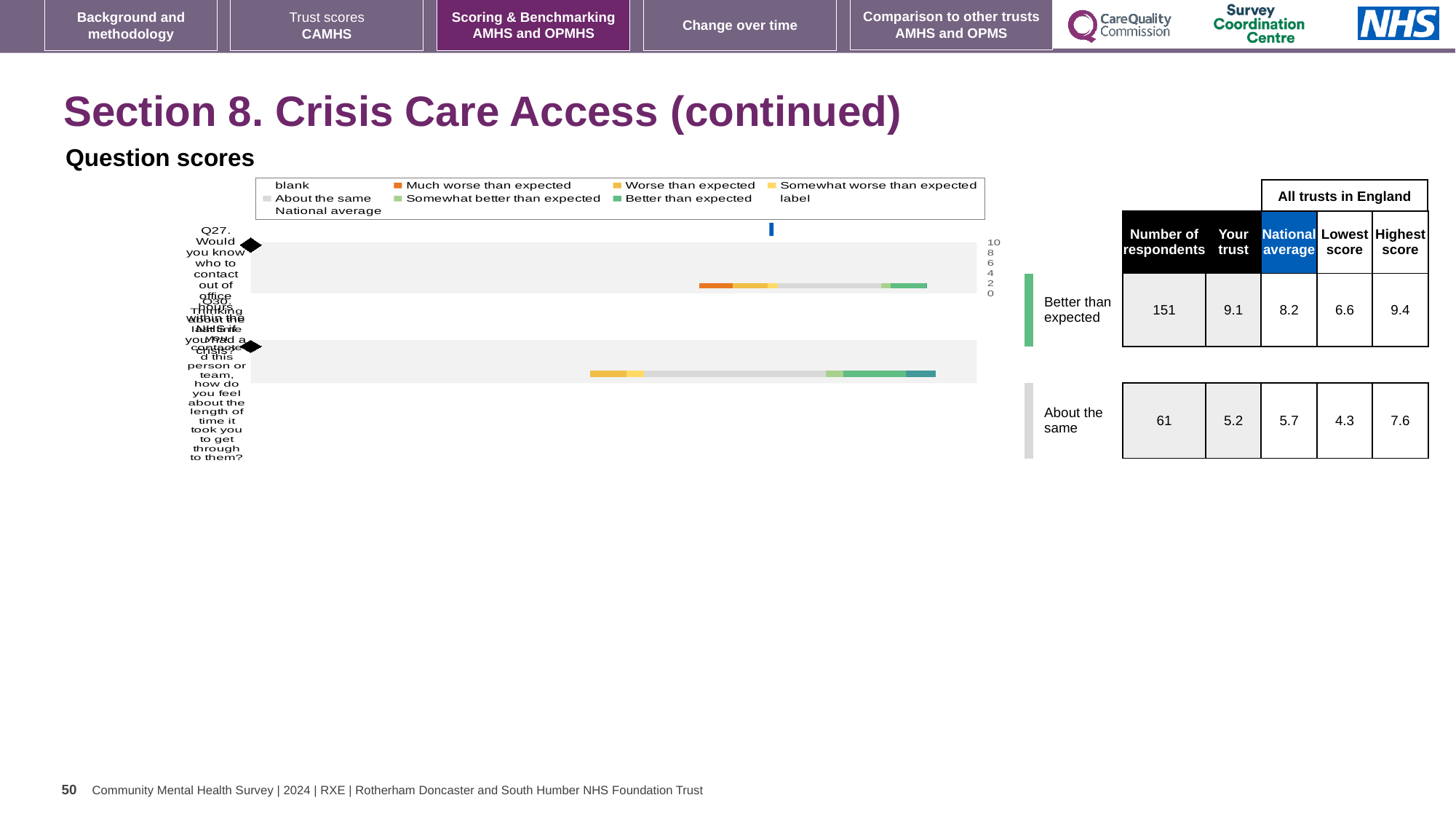
What is the 'Your trust' score for Q27 (knowing who to contact out of office hours)? 9.1 What kind of chart is used to show the question scores on this slide? bar chart How many questions (categories) are plotted in the question scores chart? 2 What is the highest value shown on the axis of the question scores chart? 10 What is the difference between the trust's score and the national average for Q27? 0.9 How many entries does the legend of the question scores chart list? 9 What is the national average score for Q30 (length of time to get through to the crisis contact)? 5.7 Which question has the higher 'Your trust' score, Q27 or Q30? Q27 What is the highest score among all trusts in England for Q30? 7.6 For Q27, is the trust's score higher or lower than the national average? higher How many respondents answered Q27? 151 What is the difference between the highest and lowest scores in England for Q30? 3.3